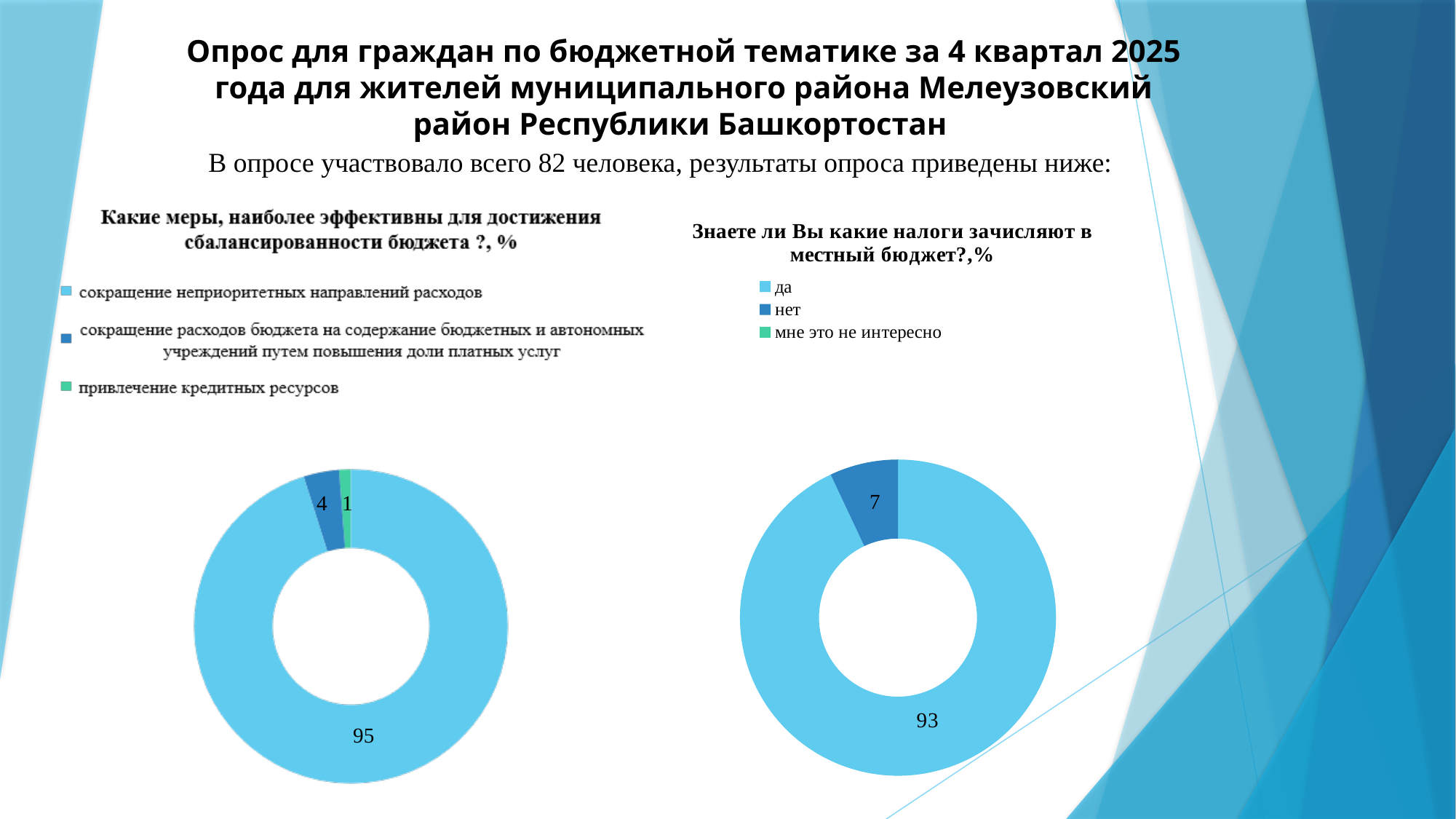
In the left chart "Какие меры, наиболее эффективны для достижения сбалансированности бюджета ?, %", which category has the largest share? сокращение неприоритетных направлений расходов In the left chart "Какие меры, наиболее эффективны для достижения сбалансированности бюджета ?, %", which category has the smallest share? привлечение кредитных ресурсов In the left chart "Какие меры, наиболее эффективны для достижения сбалансированности бюджета ?, %", what is the value for "привлечение кредитных ресурсов"? 1 In the right chart "Знаете ли Вы какие налоги зачисляют в местный бюджет?,%", what is the value for "да"? 93 In the right chart "Знаете ли Вы какие налоги зачисляют в местный бюджет?,%", what is the value for "нет"? 7 In the left chart "Какие меры, наиболее эффективны для достижения сбалансированности бюджета ?, %", what is the value for "сокращение неприоритетных направлений расходов"? 95 In the left chart "Какие меры, наиболее эффективны для достижения сбалансированности бюджета ?, %", what is the value for "сокращение расходов бюджета на содержание бюджетных и автономных учреждений путем повышения доли платных услуг"? 4 What type of chart is the left chart "Какие меры, наиболее эффективны для достижения сбалансированности бюджета ?, %"? Doughnut (pie) chart In the right chart "Знаете ли Вы какие налоги зачисляют в местный бюджет?,%", which is larger, "да" or "нет"? да In the right chart "Знаете ли Вы какие налоги зачисляют в местный бюджет?,%", what is the difference between the values for "да" and "нет"? 86 How many entries does the legend of the right chart "Знаете ли Вы какие налоги зачисляют в местный бюджет?,%" list? 3 In the left chart "Какие меры, наиболее эффективны для достижения сбалансированности бюджета ?, %", what is the difference between the values for "сокращение неприоритетных направлений расходов" and "сокращение расходов бюджета на содержание бюджетных и автономных учреждений путем повышения доли платных услуг"? 91